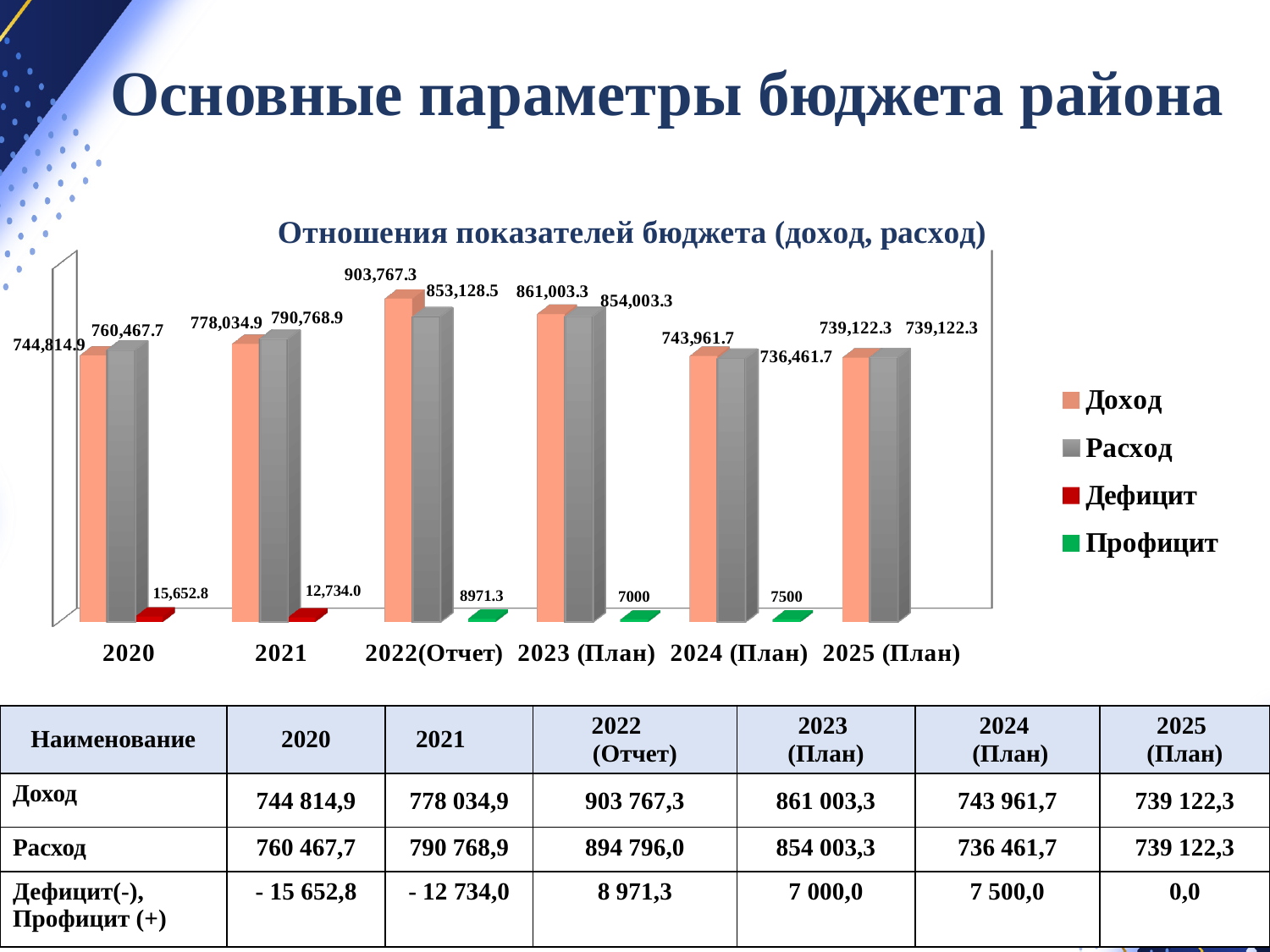
What kind of chart is shown on the slide? bar chart Which is larger in 2024 (План), Доход or Расход? Доход What is the difference between Расход and Доход in 2020? 15,652.8 Does Доход rise or fall from 2022(Отчет) to 2025 (План)? fall In which year is Доход the lowest? 2025 (План) What is the value of Расход for 2021? 790,768.9 How many years are shown on the x axis of the chart? 6 In which year is Доход the highest? 2022(Отчет) What is the value of Профицит for 2024 (План)? 7500 What is the value of Доход for 2020? 744,814.9 How many series does the chart legend list? 4 What is the value of Дефицит for 2021? 12,734.0